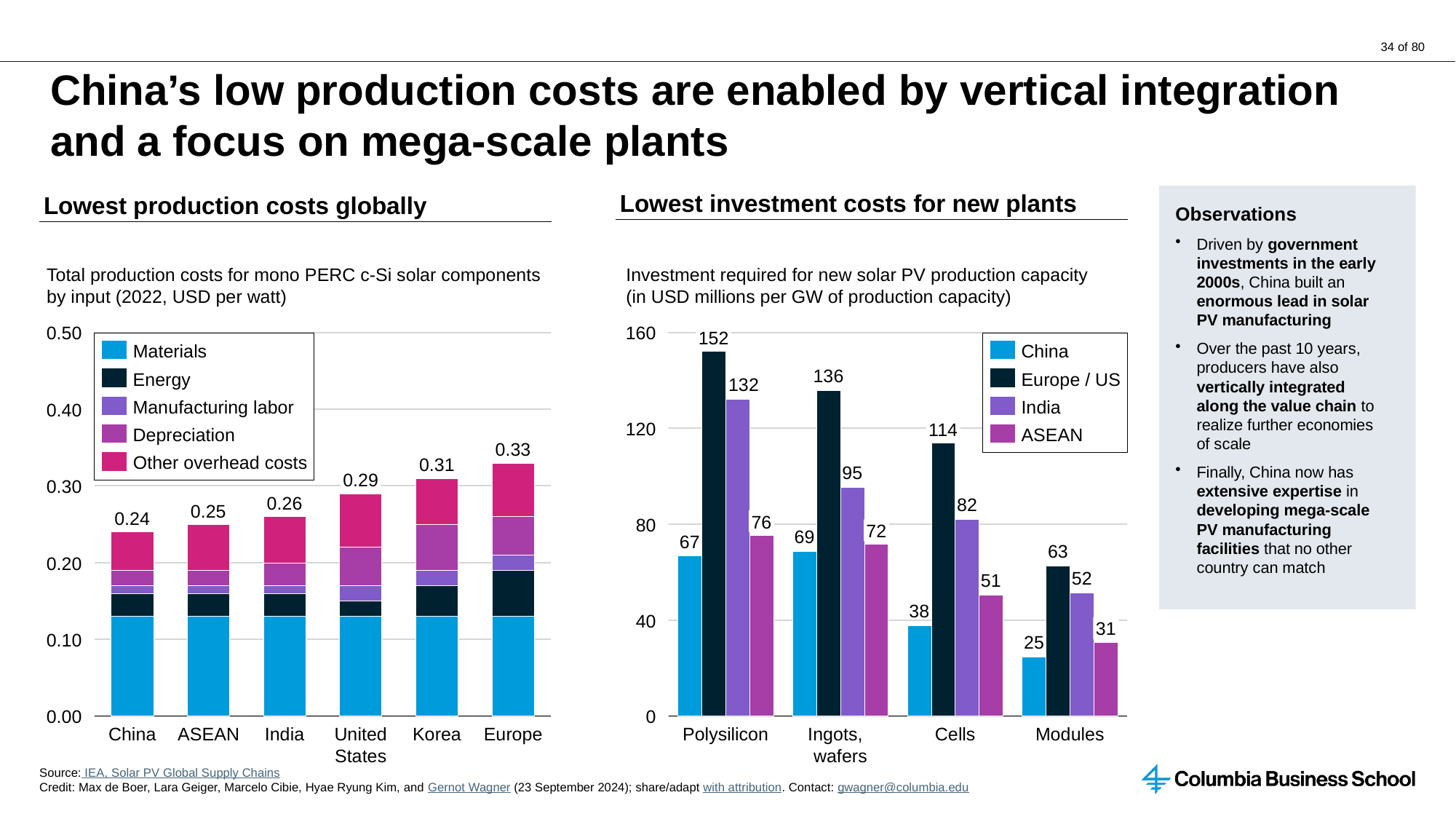
In the 'Lowest production costs globally' chart, which country has the highest total production cost? Europe In the 'Lowest production costs globally' chart, what is the difference between the total for Europe and the total for China? 0.09 What kind of chart is the 'Lowest investment costs for new plants' chart? bar chart In the 'Lowest investment costs for new plants' chart, what is the value for Europe / US for Polysilicon? 152 How many series does the legend of the 'Lowest production costs globally' chart list? 5 In the 'Lowest investment costs for new plants' chart, which region has the lowest value for Modules? China In the 'Lowest production costs globally' chart, do the total values rise or fall from China to Europe along the x axis? rise In the 'Lowest investment costs for new plants' chart, what is the difference between the Europe / US and China values for Ingots, wafers? 67 In the 'Lowest production costs globally' chart, what is the total production cost for China? 0.24 In the 'Lowest investment costs for new plants' chart, what is the value for India for Cells? 82 How many categories are shown on the x axis of the 'Lowest investment costs for new plants' chart? 4 In the 'Lowest investment costs for new plants' chart, which is larger for Polysilicon: the value for India or the value for ASEAN? India